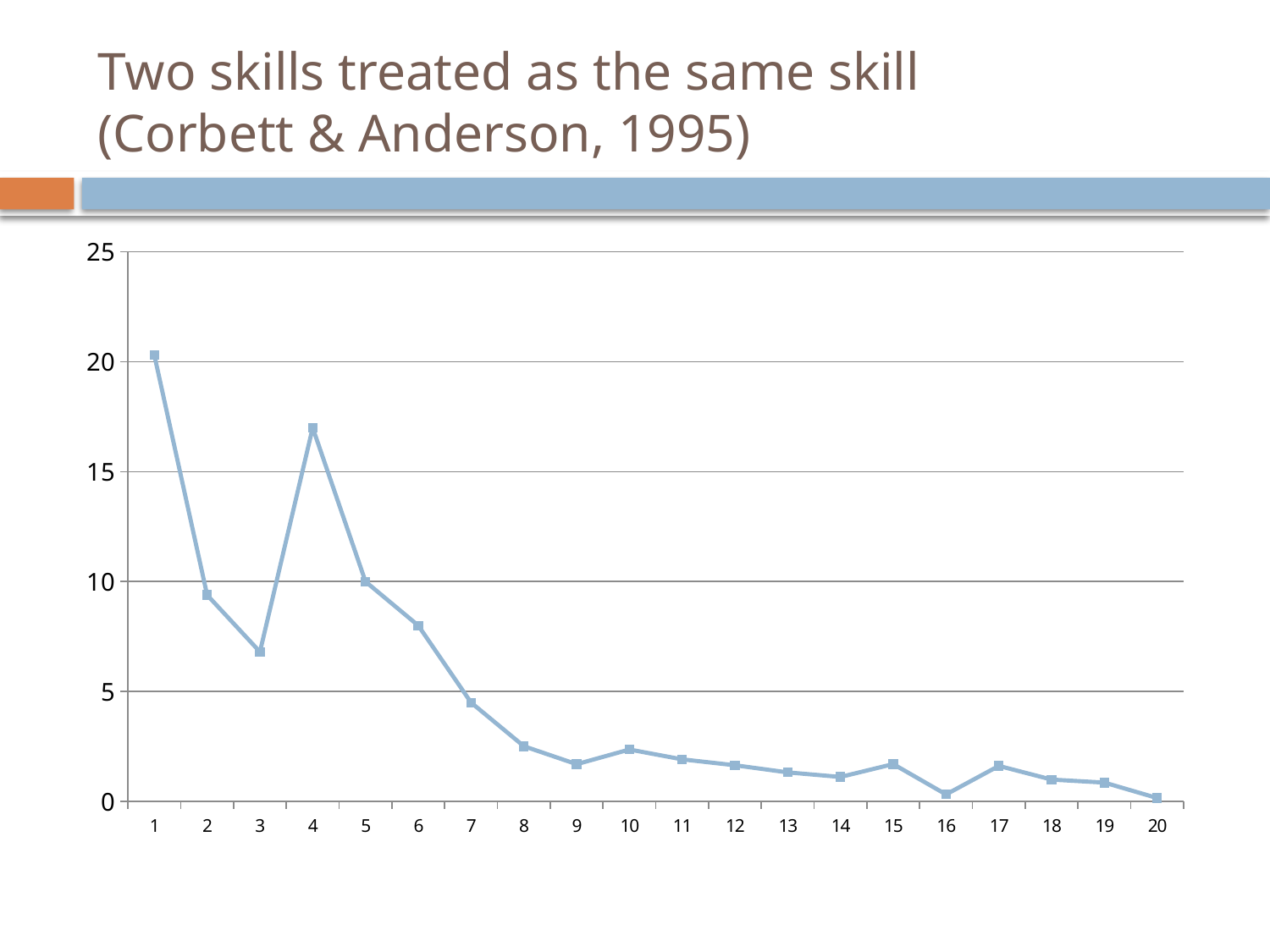
Which has the larger value, point 4 or point 2? point 4 Which has the larger value, point 6 or point 8? point 6 How many points are plotted along the x axis? 20 Is the value at point 7 greater or less than 5? less Overall, do the values rise or fall from point 1 to point 20? fall Is the value at point 4 greater or less than 15? greater What is the title of the slide containing the chart? Two skills treated as the same skill (Corbett & Anderson, 1995) What kind of chart is shown on the slide? line chart Is the value at point 3 greater or less than 5? greater Which x-axis point has the highest value? 1